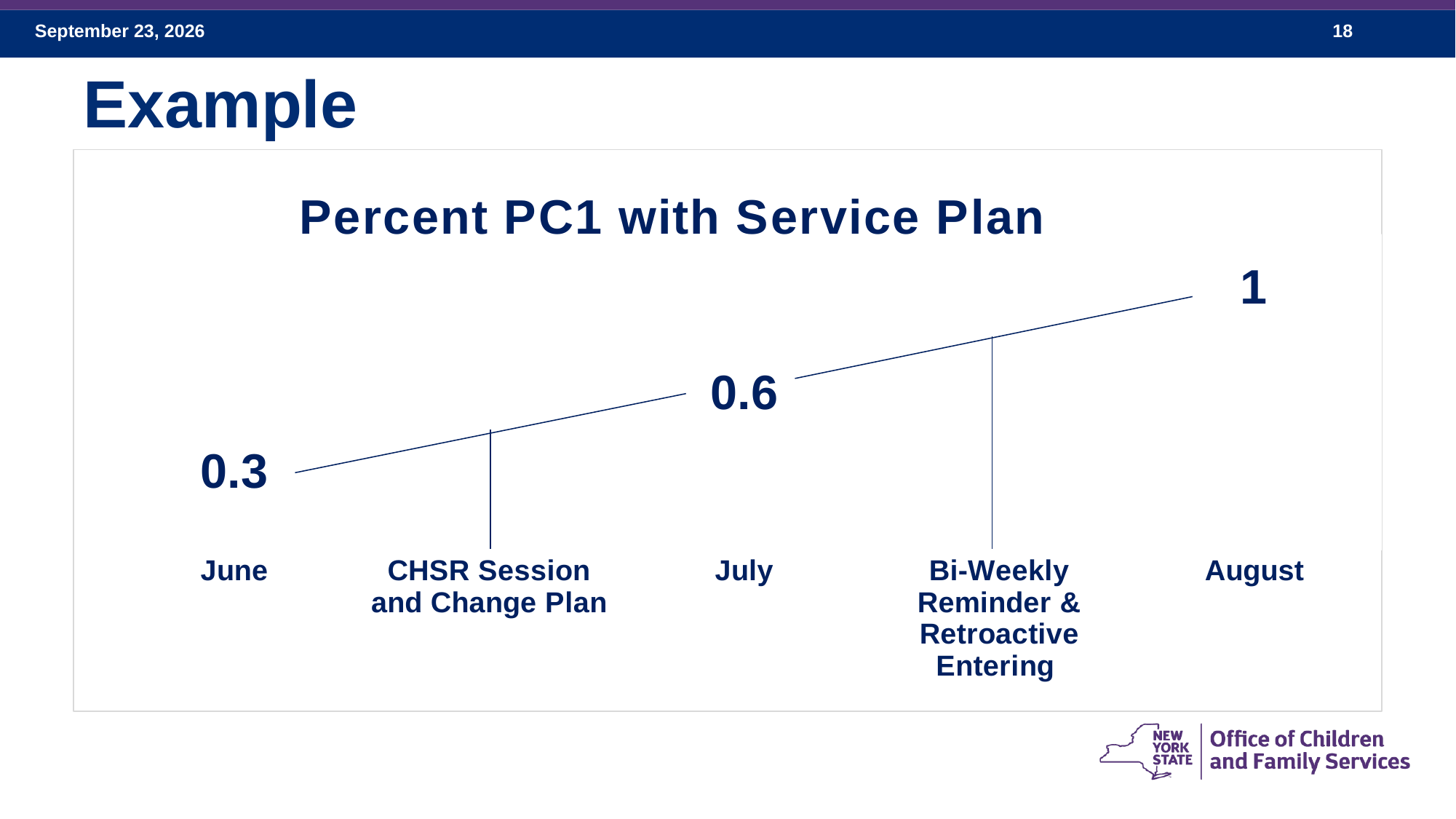
What is the value for August in the Percent PC1 with Service Plan chart? 1 What is the value for June in the Percent PC1 with Service Plan chart? 0.3 What is the value for July in the Percent PC1 with Service Plan chart? 0.6 Do the values rise or fall from June to August? Rise What kind of chart is shown on the slide? Line chart Which month has the highest value in the chart? August Which is larger, the value for June or the value for July? July What is the difference between the August value and the June value? 0.7 What is the difference between the July value and the June value? 0.3 Which month has the lowest value in the chart? June What is the title of the chart? Percent PC1 with Service Plan What is the difference between the August value and the July value? 0.4